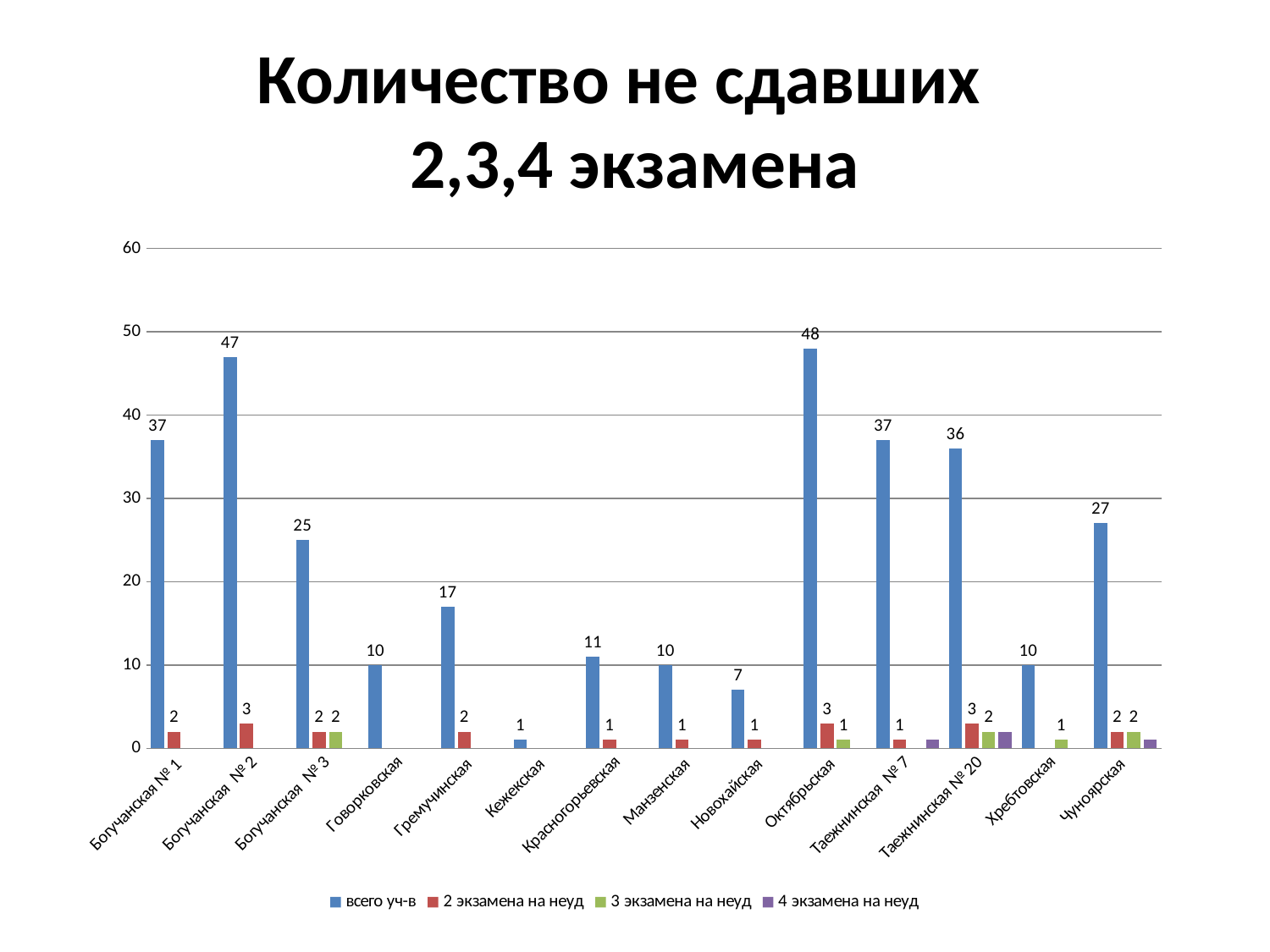
What type of chart is shown on the slide? bar chart What is the value of '3 экзамена на неуд' for Таежнинская № 20? 2 Which category has the lowest value for 'всего уч-в'? Кежекская Is the 'всего уч-в' value for Чуноярская greater or less than 30? less How many categories are shown on the x axis? 14 What is the value of '2 экзамена на неуд' for Богучанская № 2? 3 What is the value of 'всего уч-в' for Октябрьская? 48 How many series does the legend list? 4 What is the difference between the 'всего уч-в' values for Богучанская № 2 and Богучанская № 3? 22 What is the title of the chart? Количество не сдавших 2,3,4 экзамена Which category has the highest value for 'всего уч-в'? Октябрьская Which is larger, the 'всего уч-в' value for Гремучинская or for Красногорьевская? Гремучинская